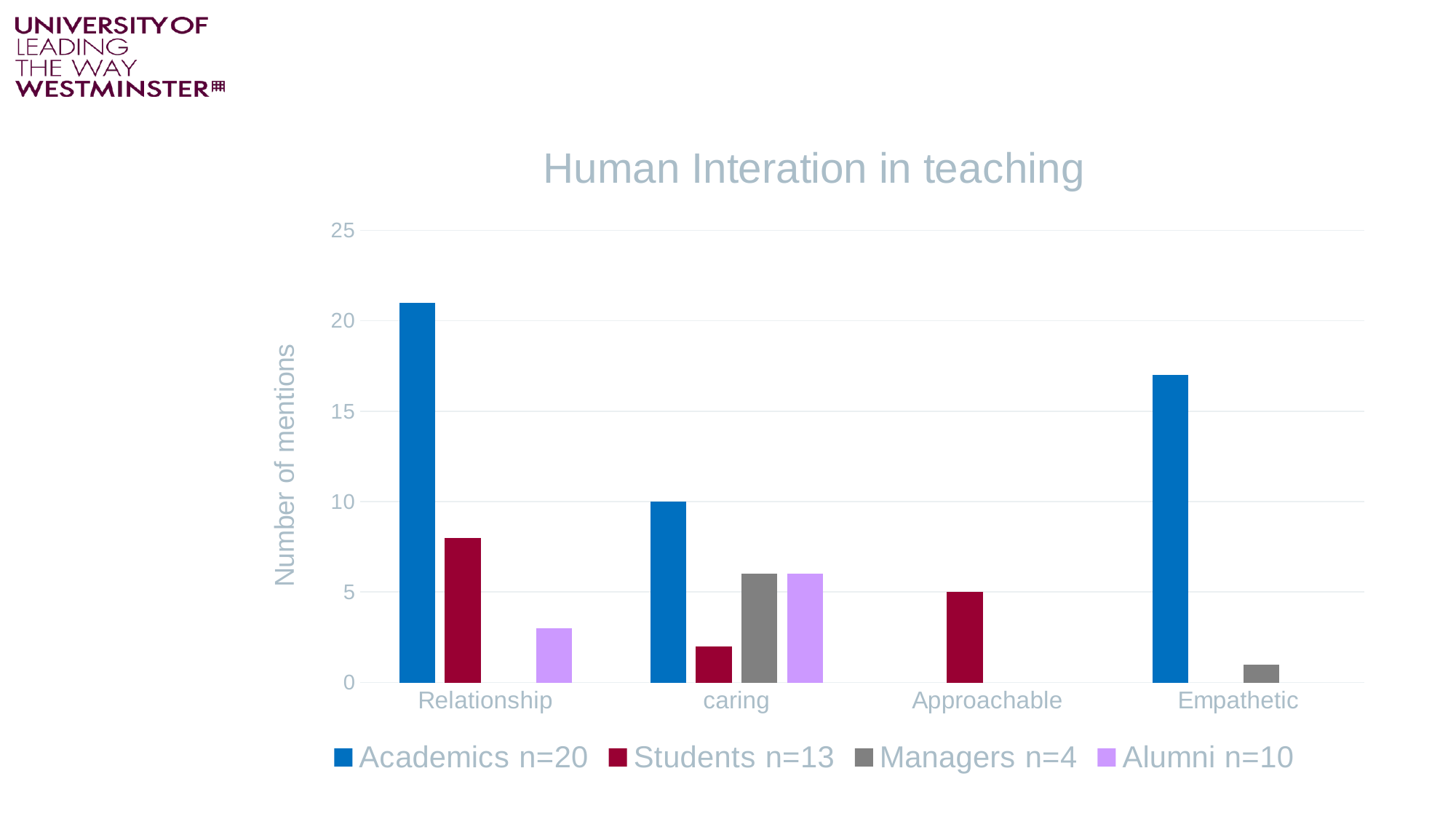
What is the label of the vertical axis? Number of mentions Which category has the highest value for Academics n=20? Relationship Is the value for Students n=13 in the Relationship category greater or less than 5? greater What is the number of mentions for Academics n=20 in the caring category? 10 Is the value for Academics n=20 in the Relationship category greater or less than 20? greater What is the number of mentions for Students n=13 in the Approachable category? 5 How many series does the legend list? 4 What type of chart is shown on the slide? bar chart Which is larger in the Relationship category: Students n=13 or Alumni n=10? Students n=13 Is the value for Academics n=20 in the Empathetic category greater or less than 15? greater What is the title of the chart? Human Interation in teaching How many categories are shown on the x axis? 4